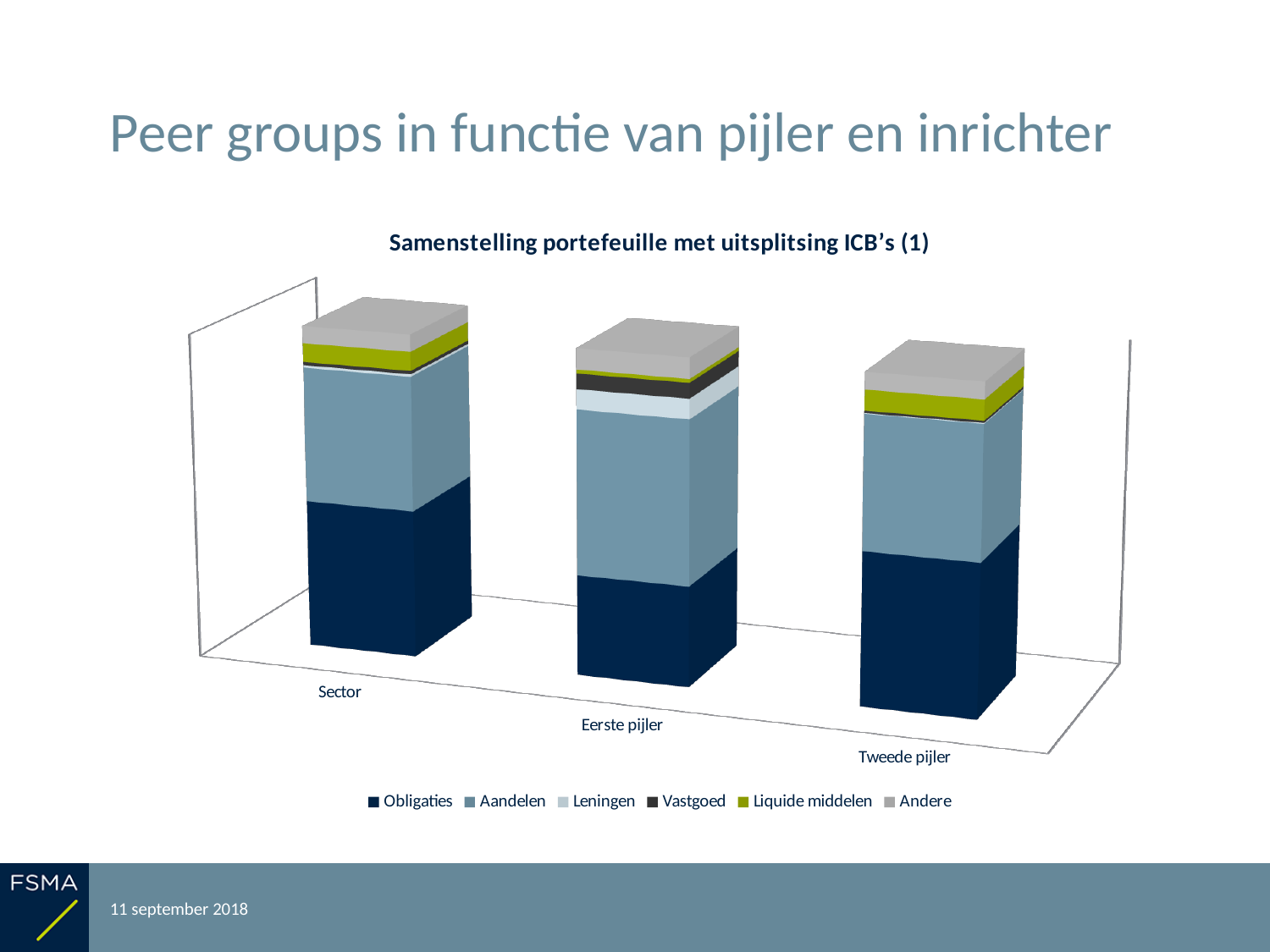
What are the three categories shown on the x axis? Sector, Eerste pijler, Tweede pijler What kind of chart is shown on the slide? Stacked bar chart Which category has the largest Aandelen segment? Eerste pijler What is the title of the chart? Samenstelling portefeuille met uitsplitsing ICB's (1) Which series is shown in the darkest blue at the bottom of each bar? Obligaties Which category has the smallest Obligaties segment? Eerste pijler How many series does the chart's legend list? 6 Which category has the largest Leningen segment? Eerste pijler Which category has the largest Vastgoed segment? Eerste pijler How many categories are shown along the x axis of the chart? 3 In the Eerste pijler bar, which segment is larger: Obligaties or Aandelen? Aandelen